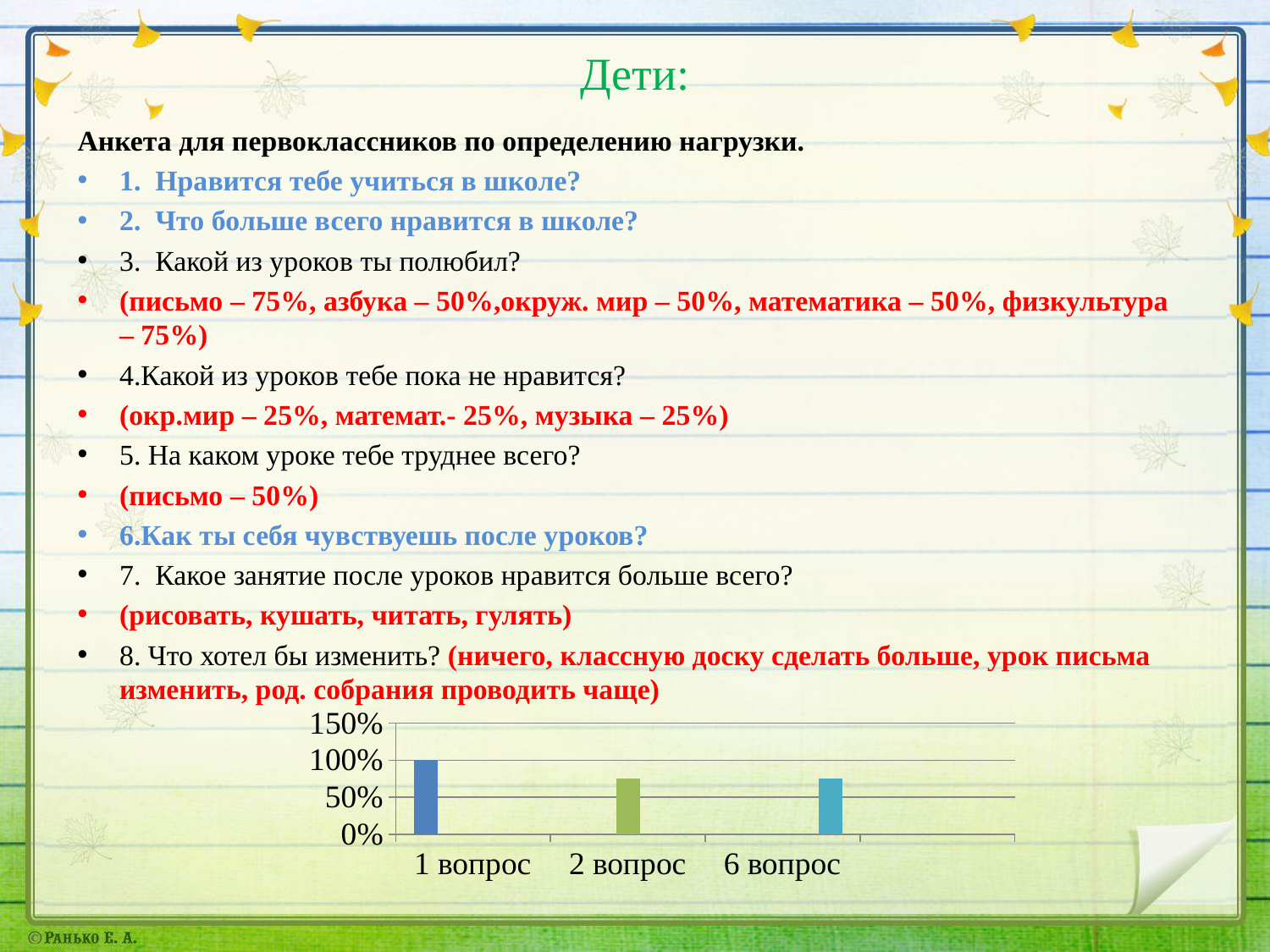
What are the category labels on the x axis of the chart? 1 вопрос, 2 вопрос, 6 вопрос What is the highest tick label shown on the y axis of the chart? 150% Is the value for 6 вопрос greater or less than 100%? less Which category has the highest bar in the chart? 1 вопрос Which is larger, the bar for 1 вопрос or the bar for 6 вопрос? 1 вопрос What kind of chart is shown at the bottom of the slide? bar chart Is the value for 2 вопрос greater or less than 100%? less Is the value for 6 вопрос greater or less than 50%? greater How many categories are shown on the x axis of the chart? 3 Which is larger, the bar for 1 вопрос or the bar for 2 вопрос? 1 вопрос What is the value of the bar for 1 вопрос? 100%